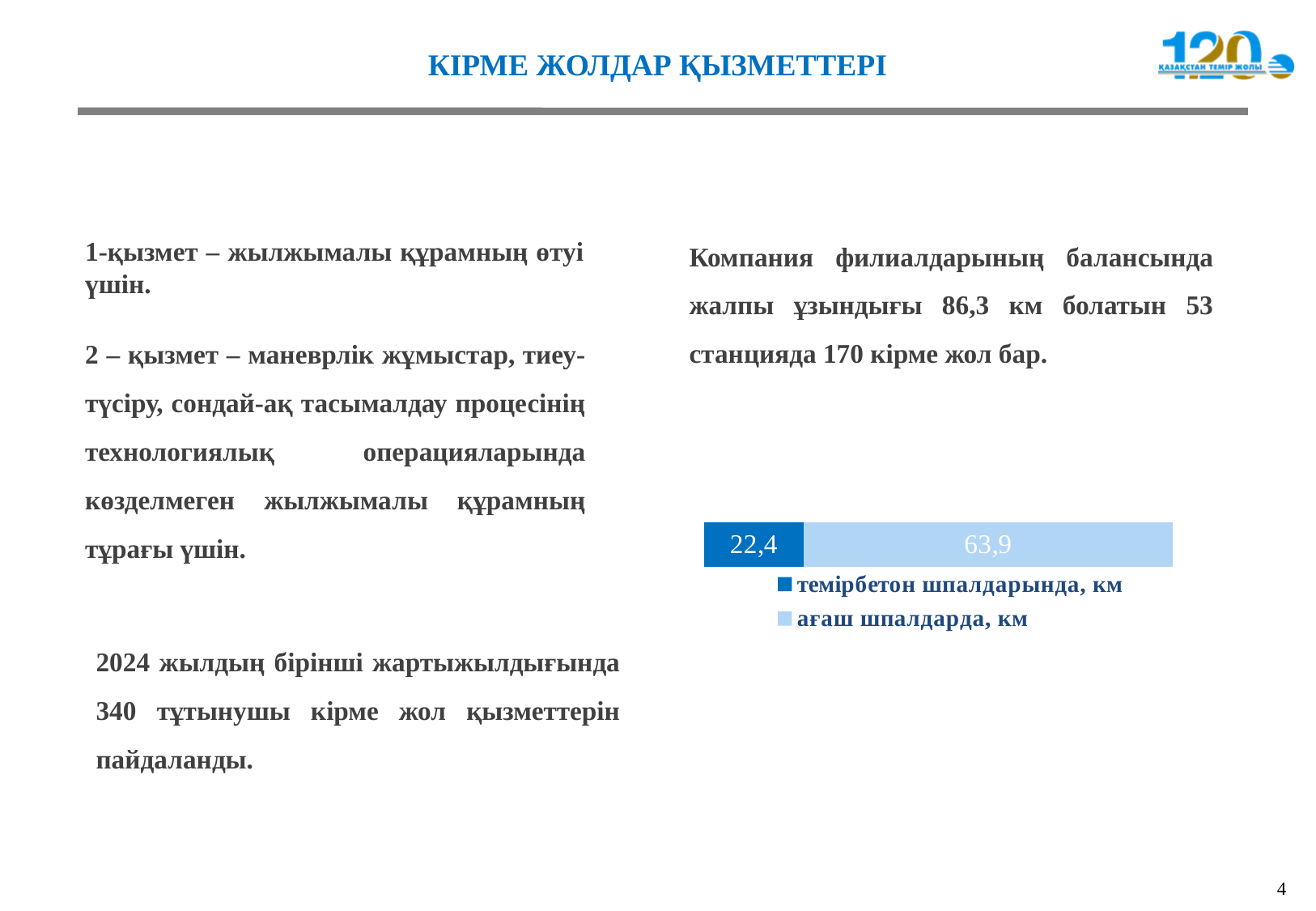
How many series does the chart legend list? 2 What is the difference between the values for "ағаш шпалдарда, км" and "темірбетон шпалдарында, км"? 41,5 Which series has the larger value in the chart, "темірбетон шпалдарында, км" or "ағаш шпалдарда, км"? ағаш шпалдарда, км Which series has the largest value in the chart? ағаш шпалдарда, км What is the value for the series "ағаш шпалдарда, км" in the chart? 63,9 What kind of chart is shown on the slide? Stacked bar chart What is the value for the series "темірбетон шпалдарында, км" in the chart? 22,4 What is the total of the stacked bar in the chart? 86,3 Which colour represents the series "ағаш шпалдарда, км" in the chart? Light blue Which colour represents the series "темірбетон шпалдарында, км" in the chart? Dark blue Which series has the smallest value in the chart? темірбетон шпалдарында, км